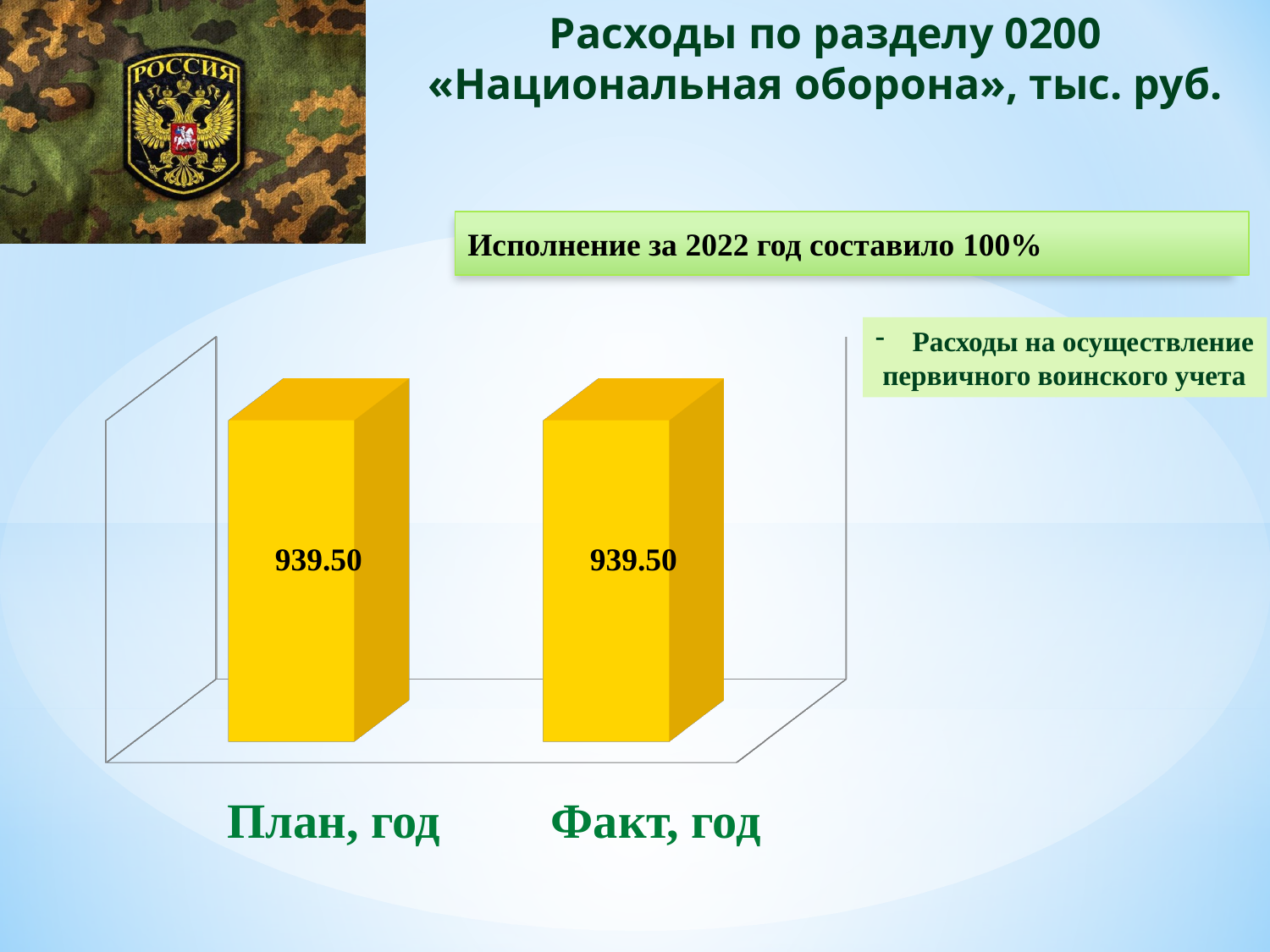
What is the difference between the values for «План, год» and «Факт, год»? 0.00 What kind of chart is shown on the slide? bar chart Are the values for «План, год» and «Факт, год» equal? yes What is the value for «Факт, год»? 939.50 How many bars are shown in the chart? 2 What is the total of the two bar values shown in the chart? 1879.00 What colour are the bars in the chart? yellow What are the category labels on the x axis of the chart? План, год; Факт, год What is the value for «План, год»? 939.50